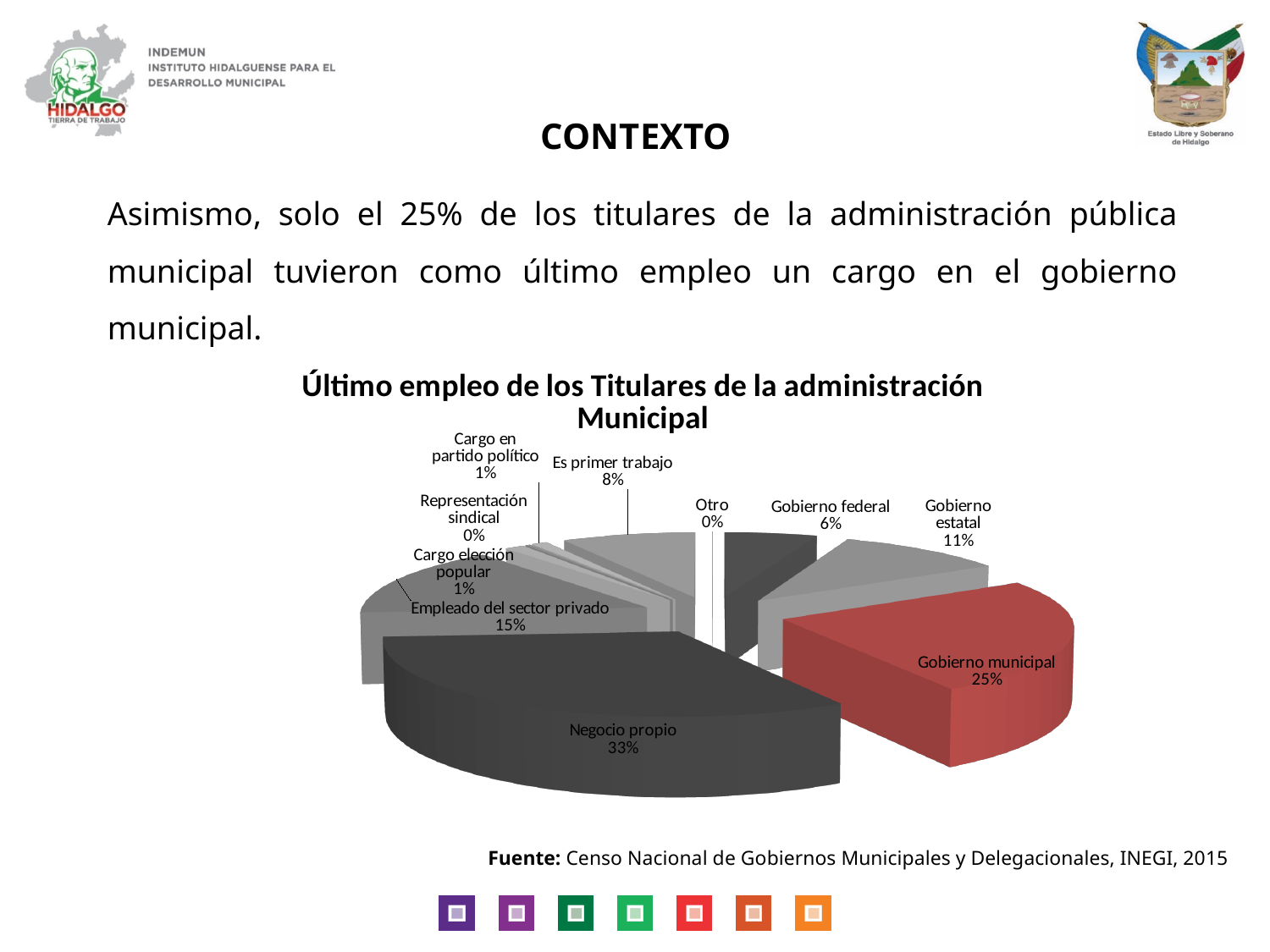
How many categories are labelled in the pie chart? 10 What is the title of the chart? Último empleo de los Titulares de la administración Municipal What is the value shown for Gobierno estatal? 11% What is the value shown for Otro? 0% Which is larger, the share for Gobierno estatal or the share for Gobierno federal? Gobierno estatal Which category has the largest share of the pie? Negocio propio What is the value shown for Es primer trabajo? 8% What share of the pie does Gobierno municipal represent? 25% What is the value shown for Empleado del sector privado? 15% What kind of chart is shown on the slide? Pie chart What is the difference between the shares of Negocio propio and Gobierno municipal? 8 percentage points What share of the pie does Negocio propio represent? 33%